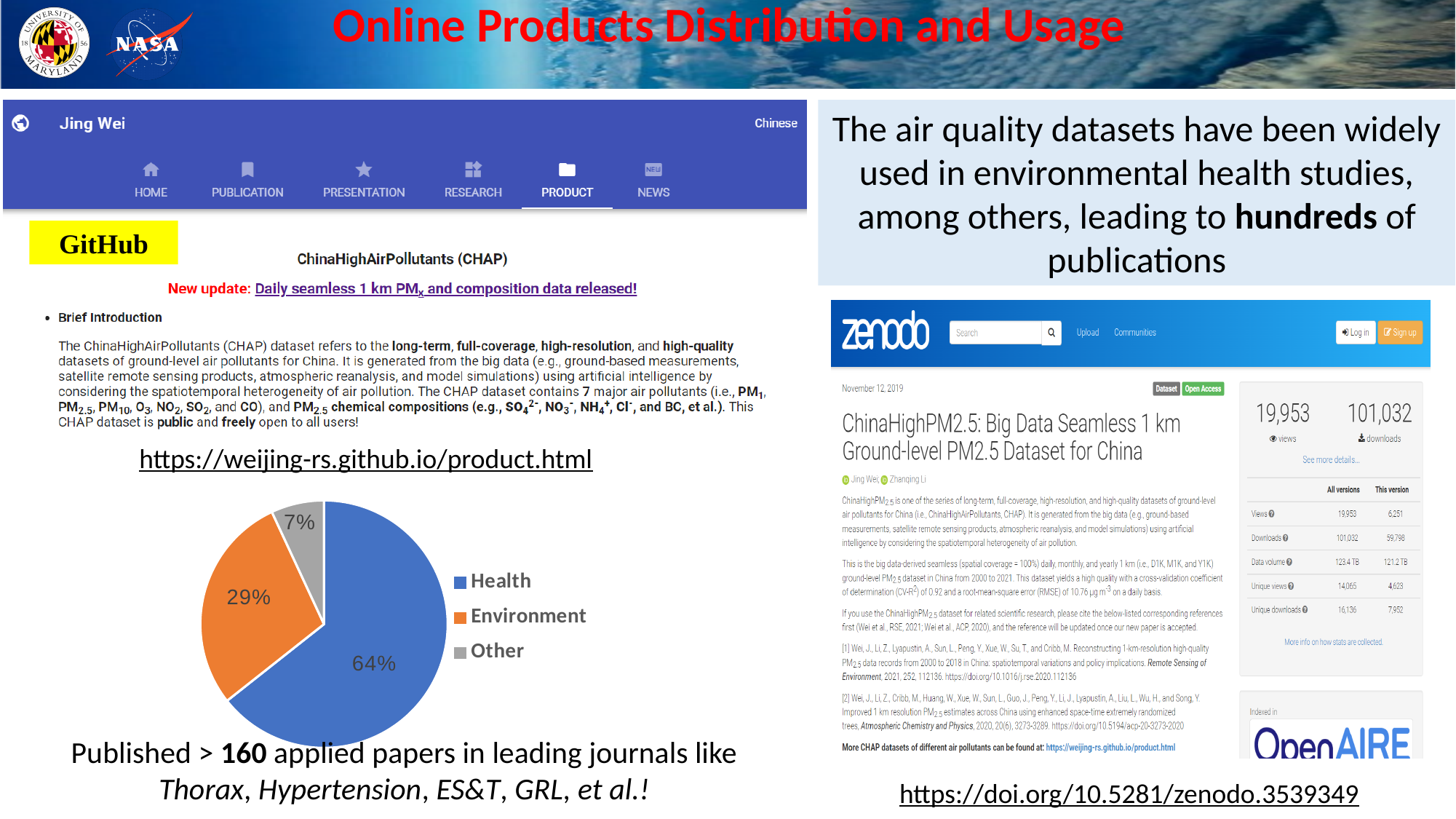
Which slice is larger, Environment or Other? Environment What share of the pie chart does Health account for? 64% How many entries does the pie chart legend list? 3 Which category has the largest slice in the pie chart? Health What share of the pie chart does Other account for? 7% What share of the pie chart does Environment account for? 29% Which category has the smallest slice in the pie chart? Other How many categories does the pie chart show? 3 What colour is the Environment slice in the pie chart? orange What is the difference in percentage points between the Health and Environment slices? 35 What kind of chart is shown on the slide? pie chart What is the difference in percentage points between the Environment and Other slices? 22